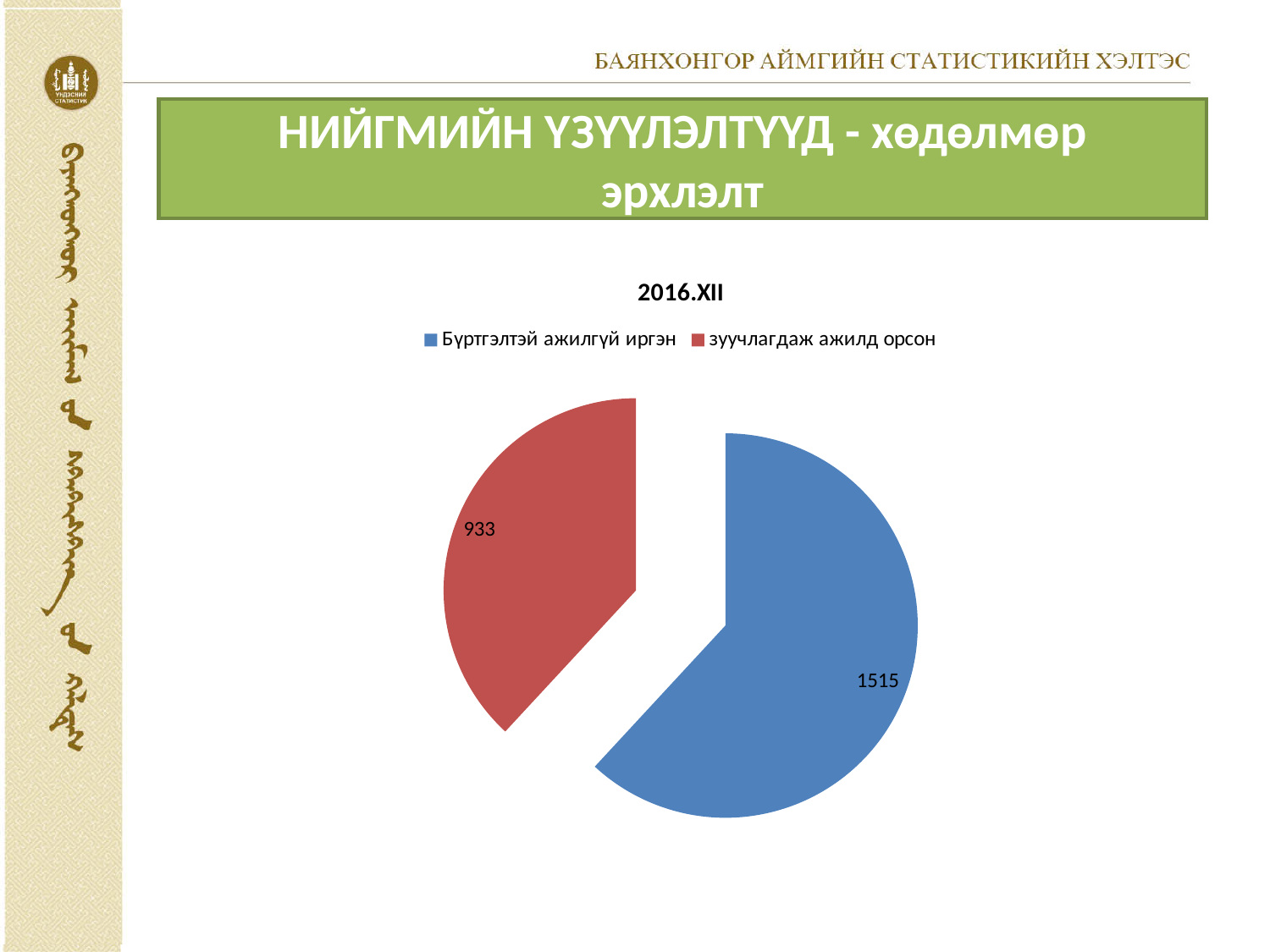
What is the value for зуучлагдаж ажилд орсон? 933 How many slices does the pie chart have? 2 What colour is the slice for Бүртгэлтэй ажилгүй иргэн? blue Which is larger, the value for Бүртгэлтэй ажилгүй иргэн or the value for зуучлагдаж ажилд орсон? Бүртгэлтэй ажилгүй иргэн What type of chart is shown on the slide? pie chart Which category has the smallest slice of the pie? зуучлагдаж ажилд орсон Which category has the largest slice of the pie? Бүртгэлтэй ажилгүй иргэн What is the title of the chart? 2016.XII How many entries does the legend list? 2 What share of the pie does the зуучлагдаж ажилд орсон slice represent? 38.1% What is the value for Бүртгэлтэй ажилгүй иргэн? 1515 What is the difference between the values for Бүртгэлтэй ажилгүй иргэн and зуучлагдаж ажилд орсон? 582